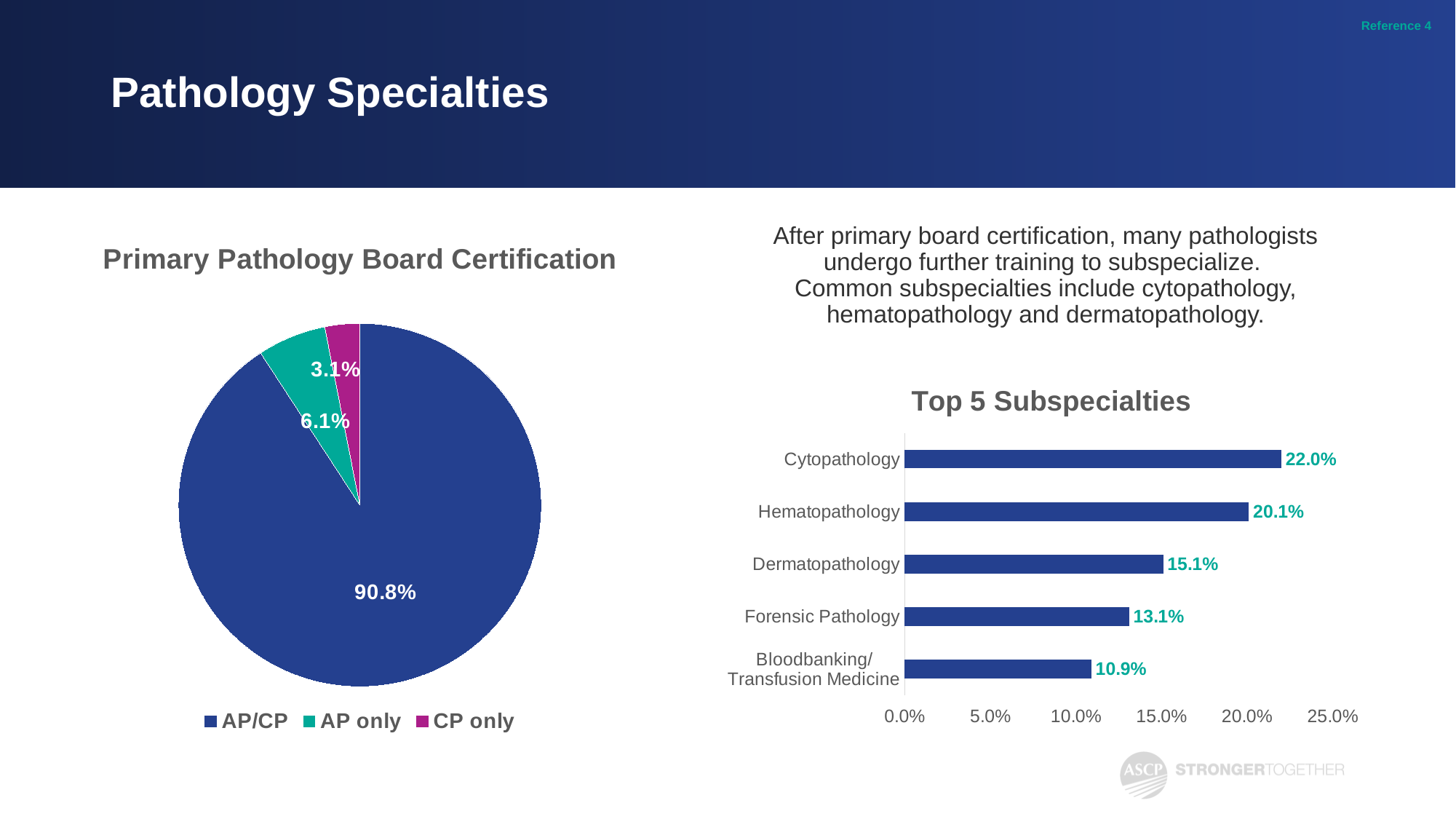
In the Top 5 Subspecialties chart, what is the difference between Cytopathology and Dermatopathology? 6.9% In the Primary Pathology Board Certification chart, what share of the pie is AP/CP? 90.8% In the Primary Pathology Board Certification chart, what is the value for CP only? 3.1% In the Top 5 Subspecialties chart, which subspecialty has the highest value? Cytopathology In the Top 5 Subspecialties chart, which is larger, Forensic Pathology or Dermatopathology? Dermatopathology What kind of chart is the Top 5 Subspecialties chart? Bar chart In the Top 5 Subspecialties chart, what is the value for Bloodbanking/Transfusion Medicine? 10.9% In the Primary Pathology Board Certification chart, what is the value for AP only? 6.1% What kind of chart is the Primary Pathology Board Certification chart? Pie chart In the Top 5 Subspecialties chart, what is the value for Hematopathology? 20.1% In the Primary Pathology Board Certification chart, how many categories does the legend list? 3 In the Primary Pathology Board Certification chart, which category has the smallest slice? CP only